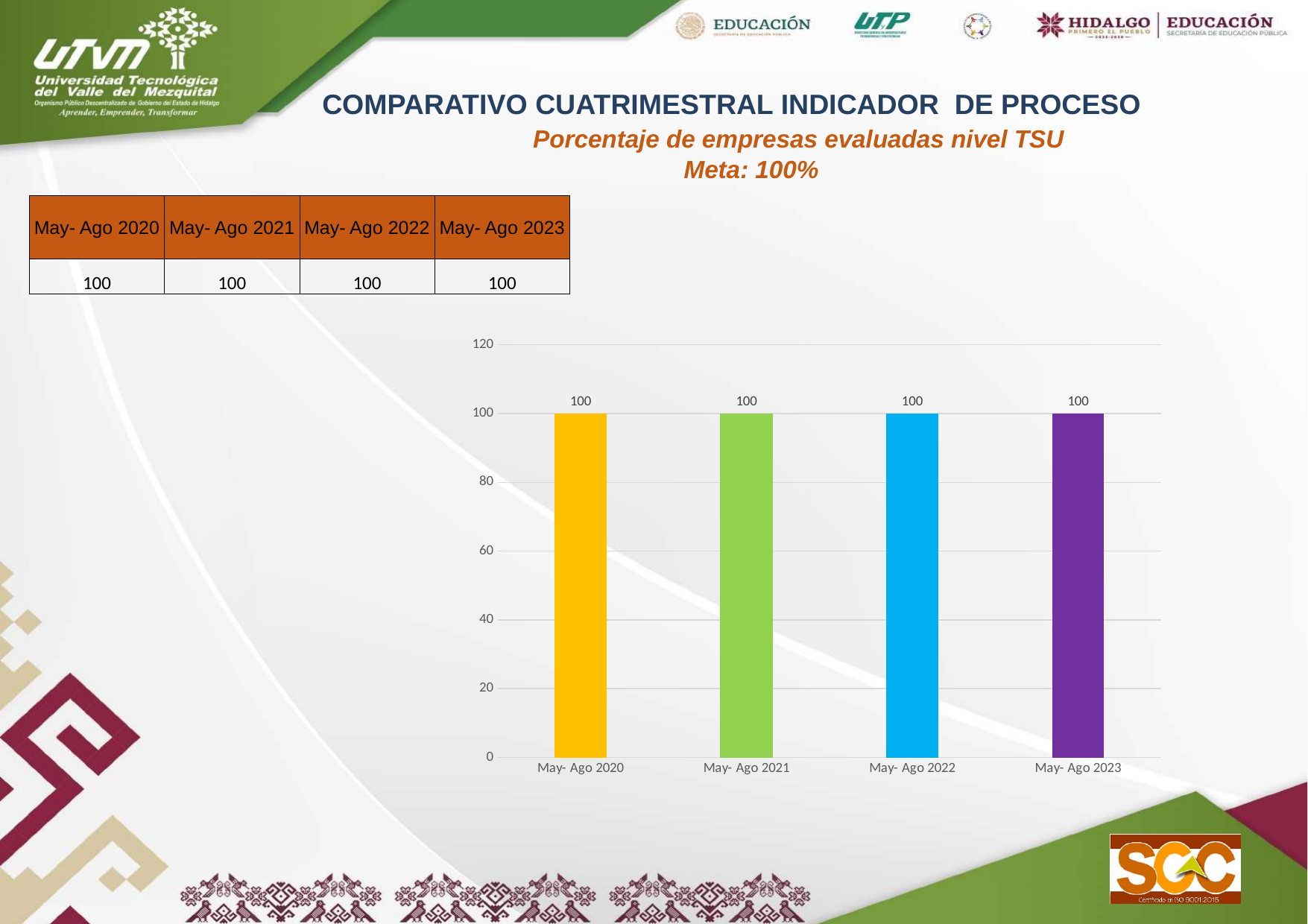
What colour is the bar for May- Ago 2023? purple What is the highest value shown on the y axis of the chart? 120 What is the value for May- Ago 2020? 100 Do the values rise, fall, or stay the same from May- Ago 2020 to May- Ago 2023? stay the same What is the difference between the values for May- Ago 2023 and May- Ago 2020? 0 Is the value for May- Ago 2022 greater or less than 80? greater What is the value for May- Ago 2021? 100 Is the value for May- Ago 2021 greater or less than 120? less What is the value for May- Ago 2023? 100 How many categories are shown on the x axis of the chart? 4 What kind of chart is shown on the slide? bar chart What is the value for May- Ago 2022? 100